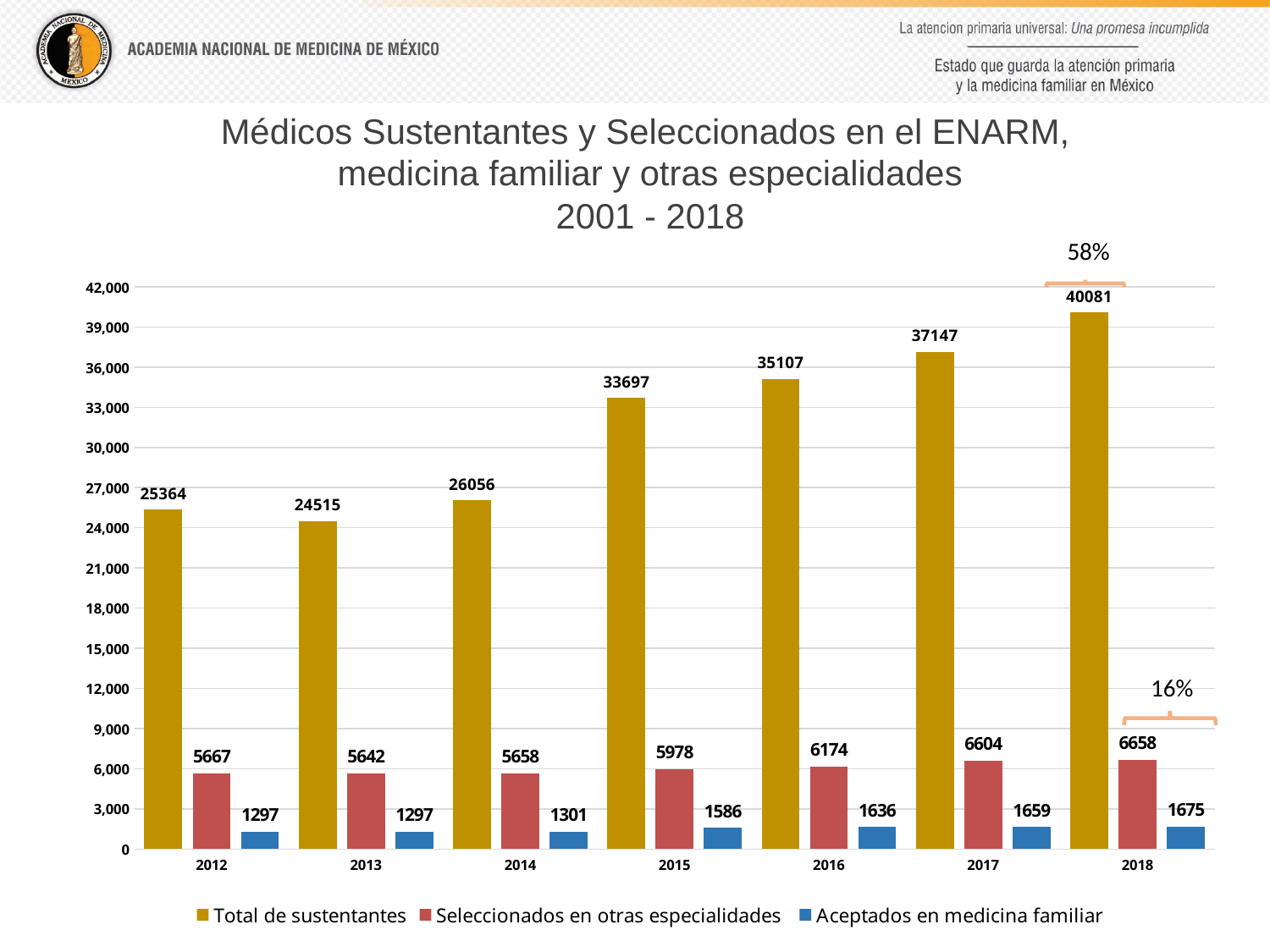
Does Aceptados en medicina familiar rise or fall from 2014 to 2018? rise What is the difference between Total de sustentantes in 2018 and in 2017? 2934 What is the value of Seleccionados en otras especialidades in 2016? 6174 What is the value of Aceptados en medicina familiar in 2018? 1675 In which year is Total de sustentantes highest? 2018 What kind of chart is shown on the slide? bar chart Is the value of Total de sustentantes in 2016 greater or less than 33,000? greater What is the value of Total de sustentantes in 2015? 33697 Which is larger: Seleccionados en otras especialidades in 2017 or in 2014? 2017 How many years are shown on the x axis? 7 How many series does the legend list? 3 In which year is Total de sustentantes lowest? 2013